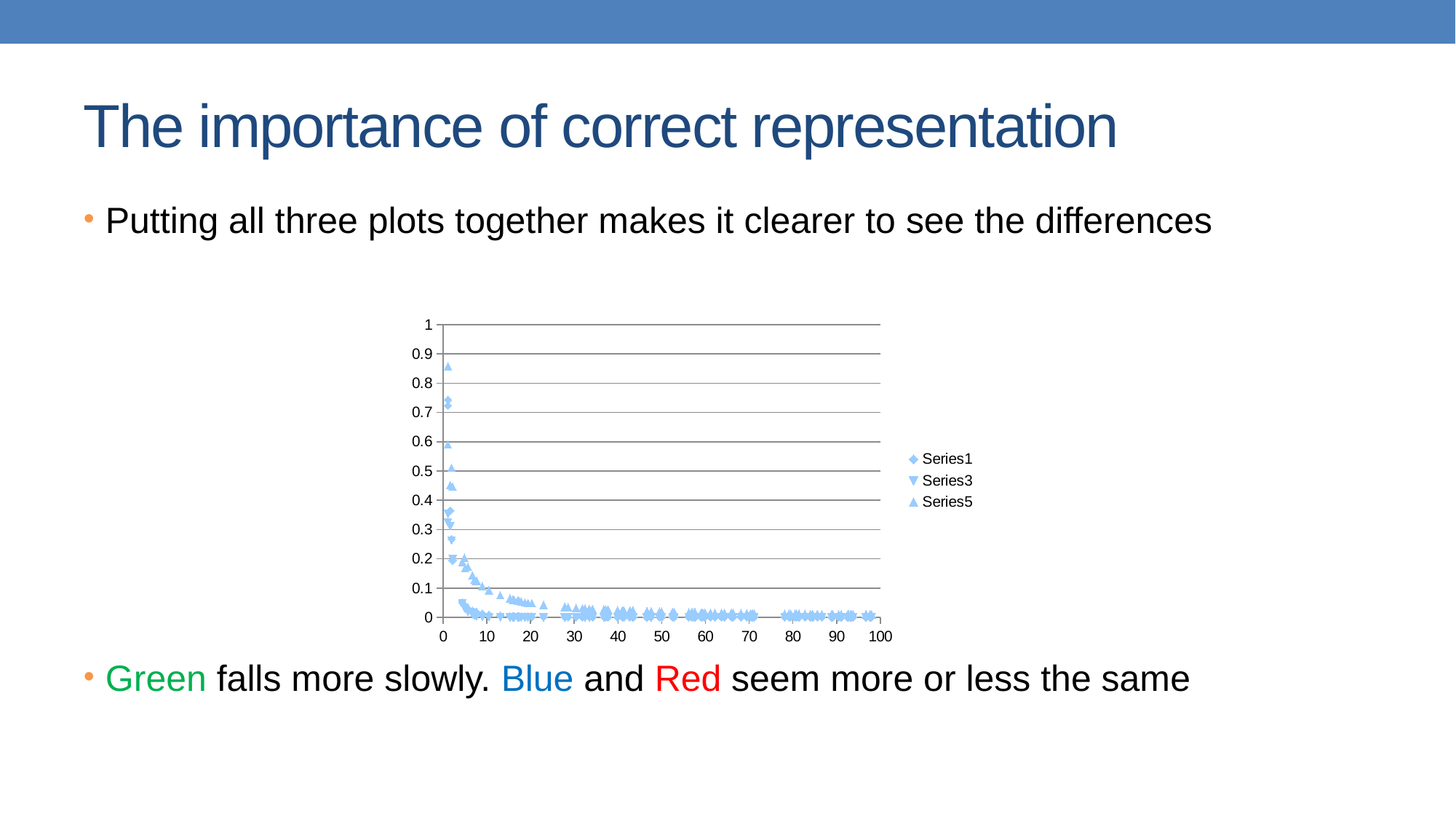
Are the Series5 values around x = 20 greater or less than 0.1? less Are the plotted values at x = 50 greater or less than 0.1? less Is the highest plotted point on the chart greater or less than 0.8? greater What is the maximum value shown on the chart's y axis? 1 Do the plotted values rise or fall as x increases along the x axis? Fall Which series has the highest plotted value on the chart? Series5 What kind of chart is shown on the slide? Scatter chart What are the names of the series listed in the chart's legend? Series1, Series3, Series5 How many series does the chart's legend list? 3